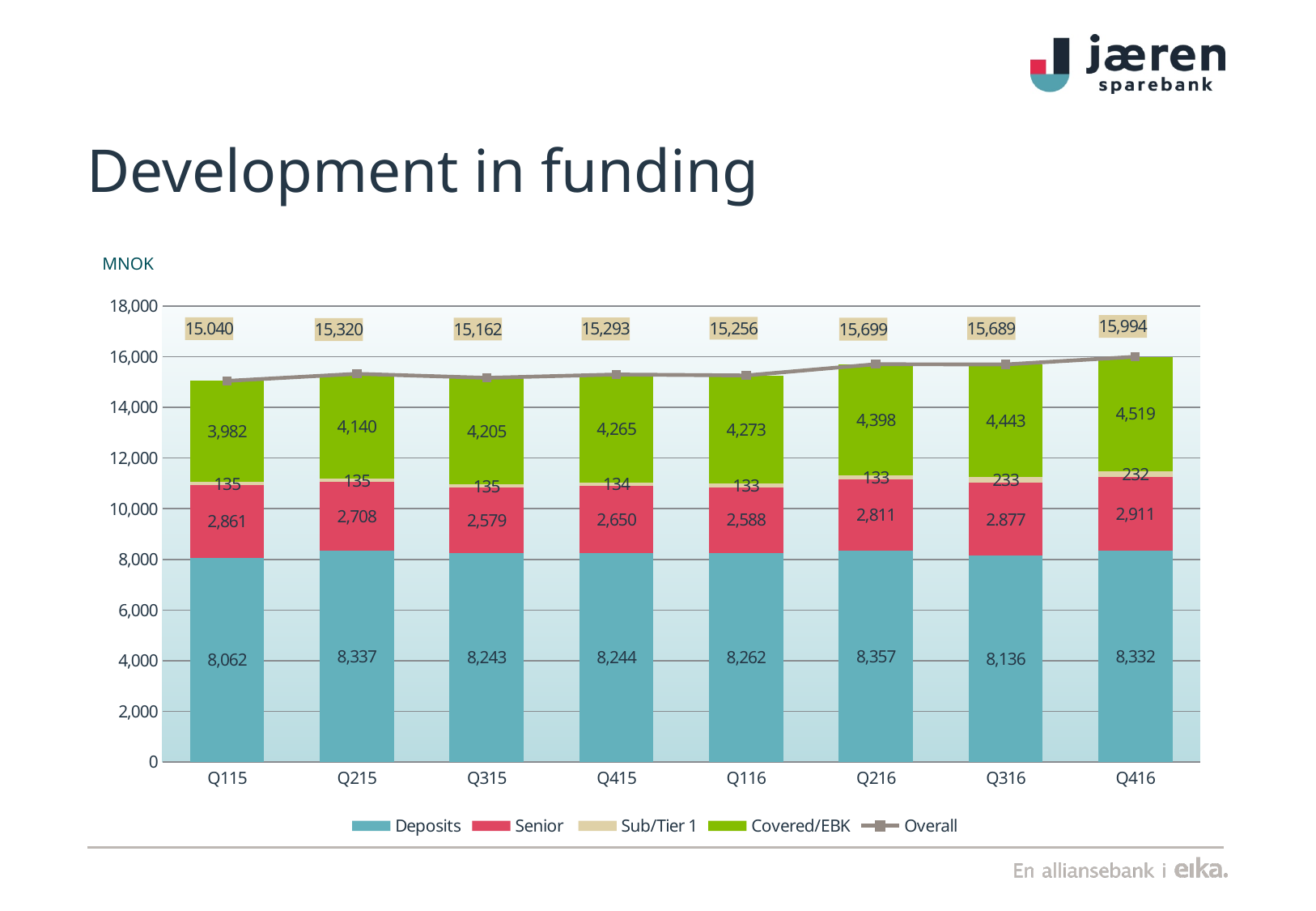
What is the total of the stacked bar for Q216? 15,699 What is the Overall value for Q316? 15,689 What kind of chart is shown on the slide? Stacked bar chart with a line How many quarters are shown on the x axis? 8 What is the difference between the Covered/EBK value in Q416 and in Q115? 537 What is the Sub/Tier 1 value for Q316? 233 In which quarter is the Senior value lowest? Q315 How many series does the legend list? 5 What is the Covered/EBK value for Q416? 4,519 What is the Deposits value for Q216? 8,357 Which quarter has the larger Senior value, Q116 or Q216? Q216 In which quarter is the Covered/EBK value highest? Q416